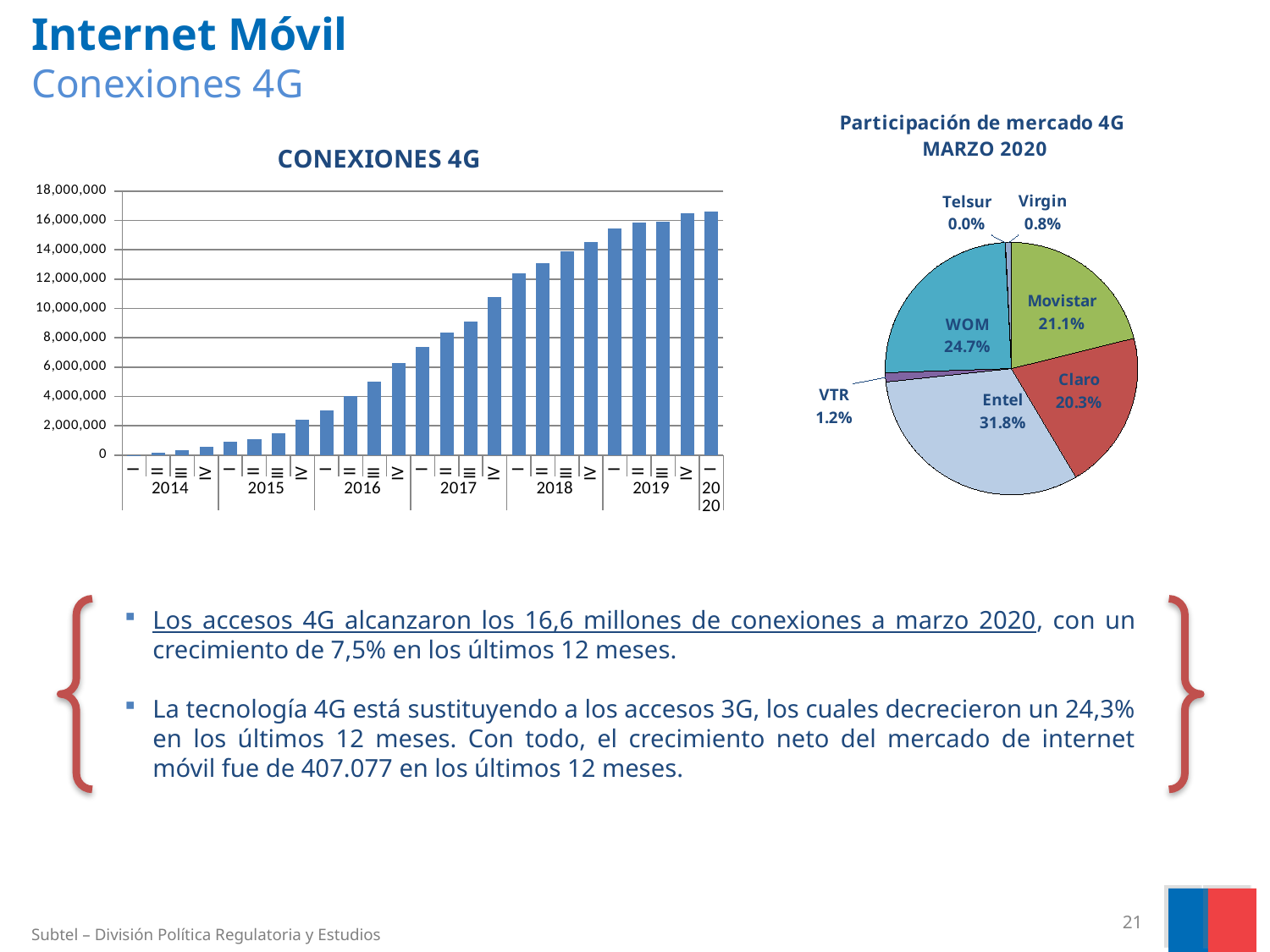
What kind of chart is the 'CONEXIONES 4G' chart on the left? bar chart In the 'Participación de mercado 4G MARZO 2020' pie chart, which operator has the smallest share? Telsur In the 'CONEXIONES 4G' chart, how many years are labelled on the x axis? 7 In the 'CONEXIONES 4G' chart, is the value for the first quarter of 2014 greater or less than 2,000,000? less In the 'Participación de mercado 4G MARZO 2020' pie chart, what is Entel's share? 31.8% In the 'CONEXIONES 4G' chart, is the value for the first quarter of 2019 greater or less than 14,000,000? greater In the 'Participación de mercado 4G MARZO 2020' pie chart, which has the larger share, Movistar or Claro? Movistar In the 'Participación de mercado 4G MARZO 2020' pie chart, what is the difference between Entel's share and WOM's share? 7.1% What kind of chart is the 'Participación de mercado 4G MARZO 2020' chart on the right? pie chart In the 'CONEXIONES 4G' chart, do the values rise or fall from 2014 to 2020? rise In the 'Participación de mercado 4G MARZO 2020' pie chart, what is WOM's share? 24.7% In the 'Participación de mercado 4G MARZO 2020' pie chart, which operator has the largest share? Entel